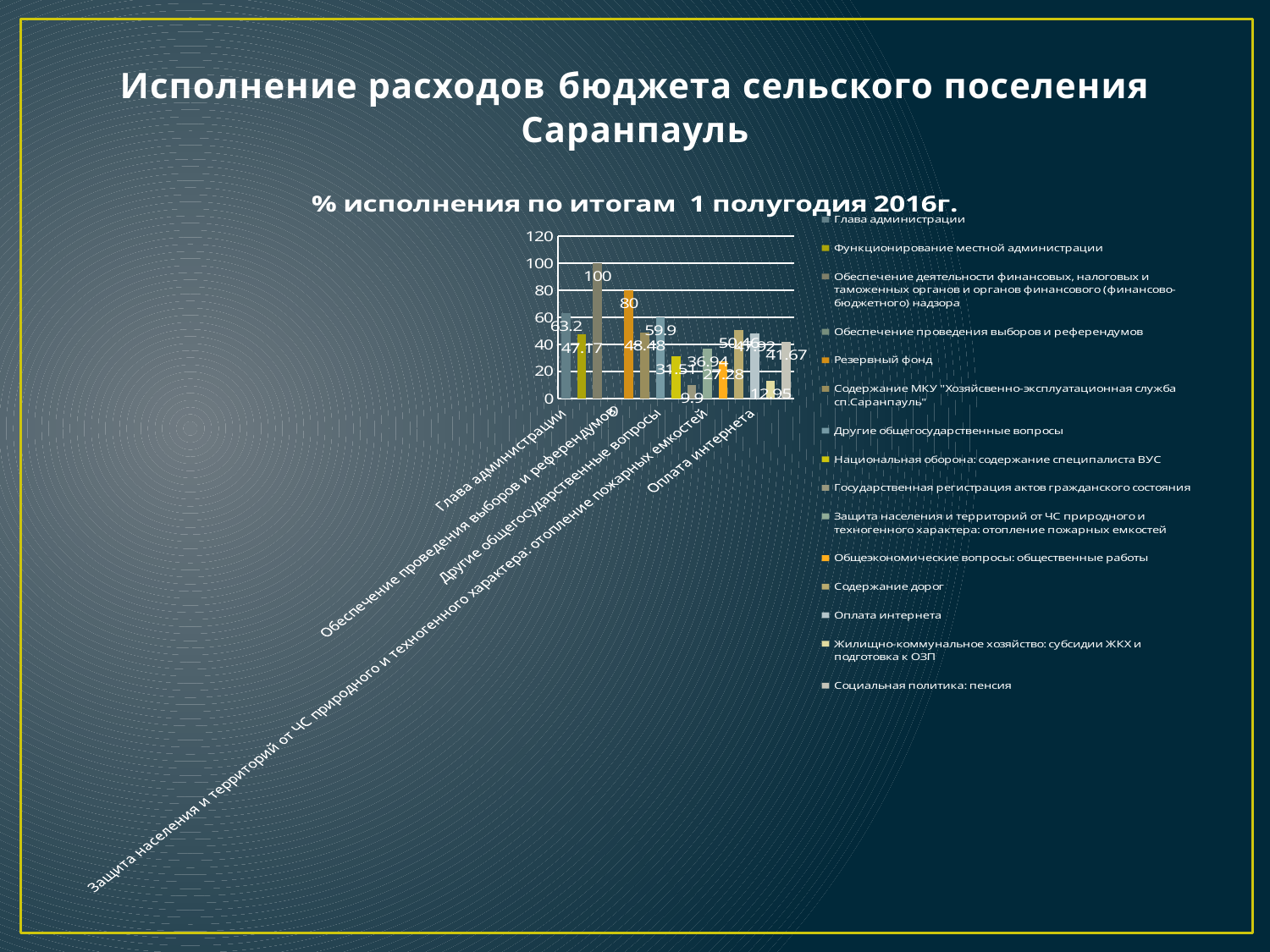
What kind of chart is shown on the slide? bar chart What is the value for Функционирование местной администрации? 47.17 What is the value for Резервный фонд? 80 How many series does the legend list? 15 What is the highest value shown in the chart? 100 What is the value for Глава администрации? 63.2 Which category has the highest value? Обеспечение деятельности финансовых, налоговых и таможенных органов и органов финансового (финансово-бюджетного) надзора Which is larger: the value for Функционирование местной администрации or the value for Глава администрации? Глава администрации What is the title of the chart? % исполнения по итогам 1 полугодия 2016г.